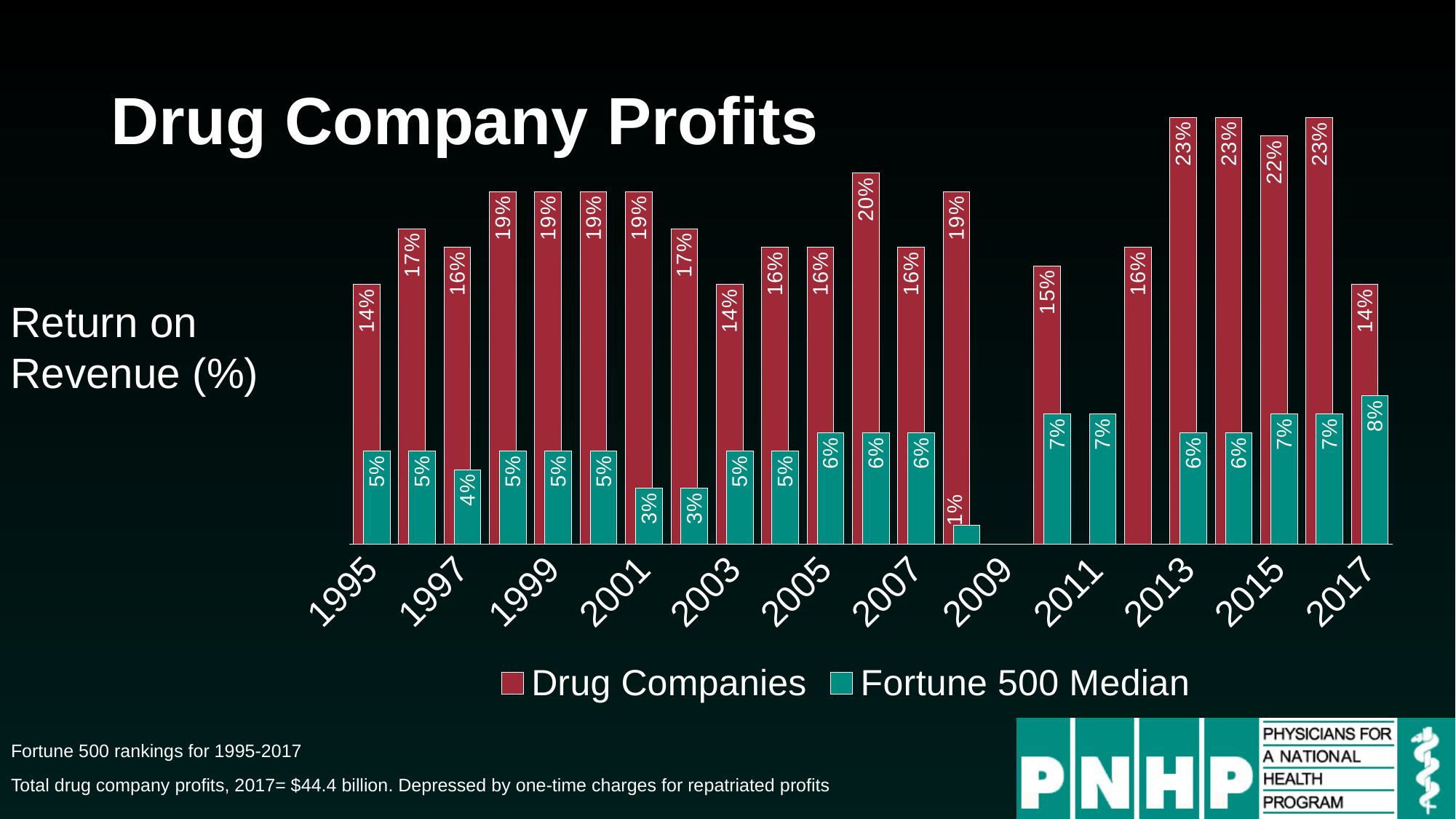
What is the title of the chart? Drug Company Profits What is the Drug Companies return on revenue in 1995? 14% What is the highest value shown for the Drug Companies series? 23% What is the Fortune 500 Median return on revenue in 2017? 8% What type of chart is shown on the slide? Bar chart How many series does the legend list? 2 What is the Fortune 500 Median return on revenue in 1997? 4% What is the lowest value shown for the Fortune 500 Median series? 1% What is the Drug Companies return on revenue in 2015? 22% In 2013, which is larger: Drug Companies or Fortune 500 Median? Drug Companies What is the difference between the Drug Companies and Fortune 500 Median values in 2017? 6 percentage points What is the Drug Companies return on revenue in 2013? 23%